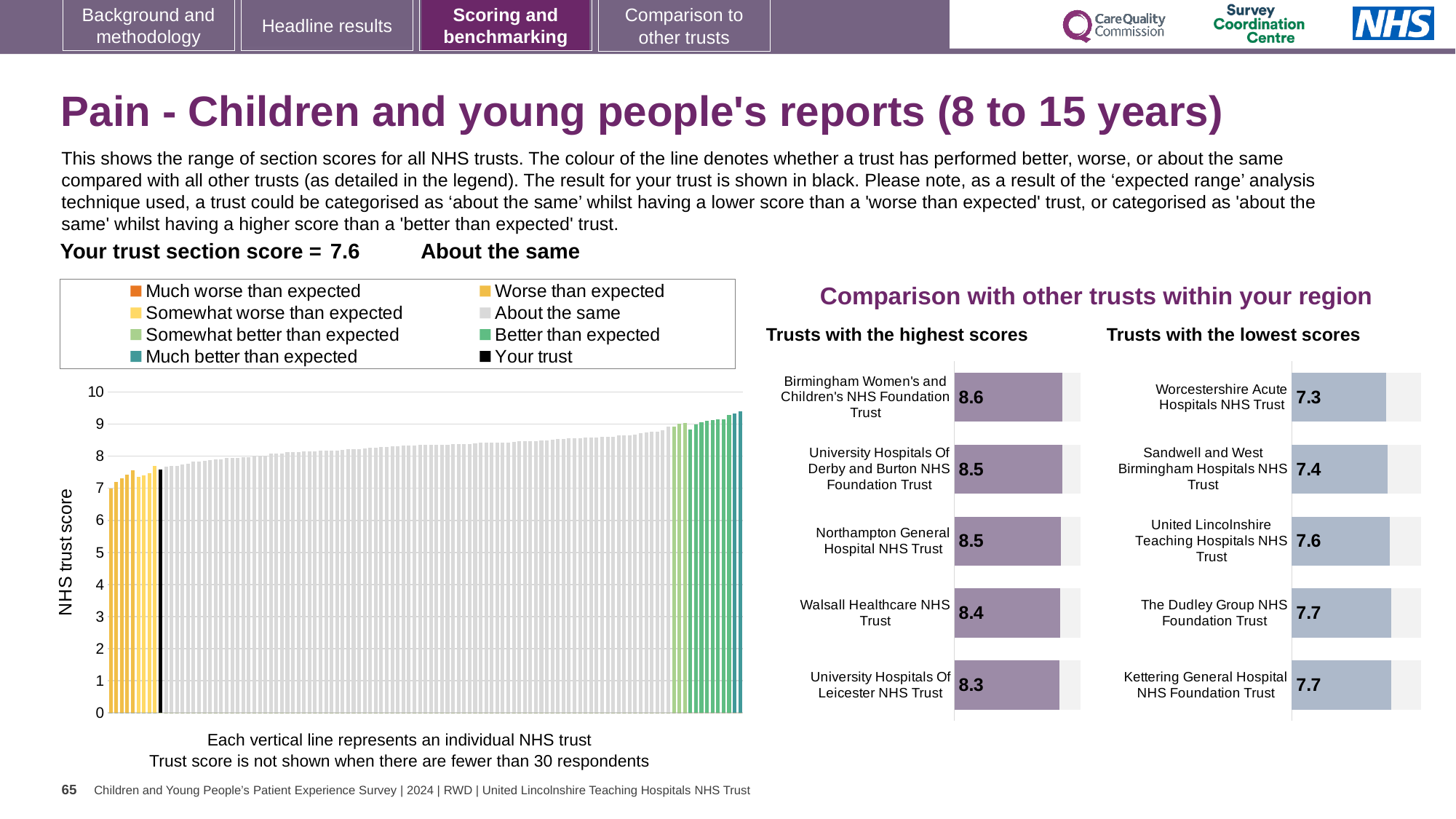
What is the difference between the score for Birmingham Women's and Children's NHS Foundation Trust and the score for University Hospitals Of Leicester NHS Trust in the 'Trusts with the highest scores' chart? 0.3 In the 'Trusts with the highest scores' chart, what is the score for Birmingham Women's and Children's NHS Foundation Trust? 8.6 In the large chart on the left, do the trust scores rise or fall from left to right? Rise In the 'Trusts with the lowest scores' chart, what is the score for Worcestershire Acute Hospitals NHS Trust? 7.3 In the 'Trusts with the lowest scores' chart, what is the score for United Lincolnshire Teaching Hospitals NHS Trust? 7.6 How many trusts are shown in the 'Trusts with the lowest scores' chart? 5 How many entries does the legend of the large chart on the left list? 8 In the 'Trusts with the lowest scores' chart, which trust has the lowest score? Worcestershire Acute Hospitals NHS Trust In the 'Trusts with the lowest scores' chart, which has the larger score: Sandwell and West Birmingham Hospitals NHS Trust or The Dudley Group NHS Foundation Trust? The Dudley Group NHS Foundation Trust In the 'Trusts with the highest scores' chart, what is the score for Walsall Healthcare NHS Trust? 8.4 What kind of chart is the large chart on the left of the slide? Bar chart In the 'Trusts with the highest scores' chart, which trust has the lowest score? University Hospitals Of Leicester NHS Trust